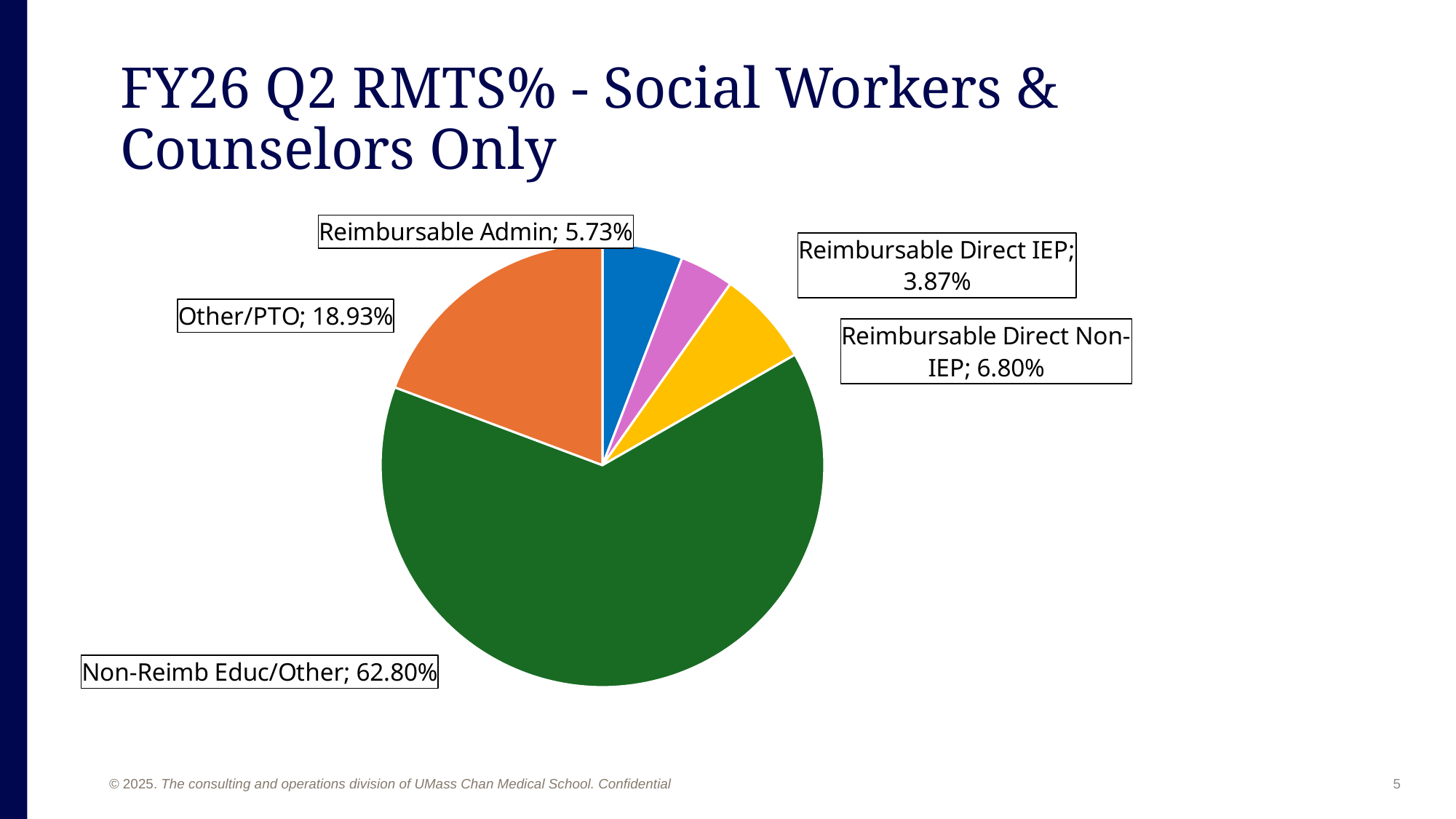
Which category has the smallest slice? Reimbursable Direct IEP What is the value for Other/PTO? 18.93% What is the value for Non-Reimb Educ/Other? 62.80% What is the difference between Other/PTO and Reimbursable Admin? 13.20% How many slices does the pie chart have? 5 What kind of chart is shown on the slide? pie chart What is the value for Reimbursable Direct IEP? 3.87% Which is larger, Reimbursable Direct Non-IEP or Reimbursable Admin? Reimbursable Direct Non-IEP What colour is the Non-Reimb Educ/Other slice? green What is the value for Reimbursable Direct Non-IEP? 6.80% What is the value for Reimbursable Admin? 5.73% Which category has the largest slice? Non-Reimb Educ/Other